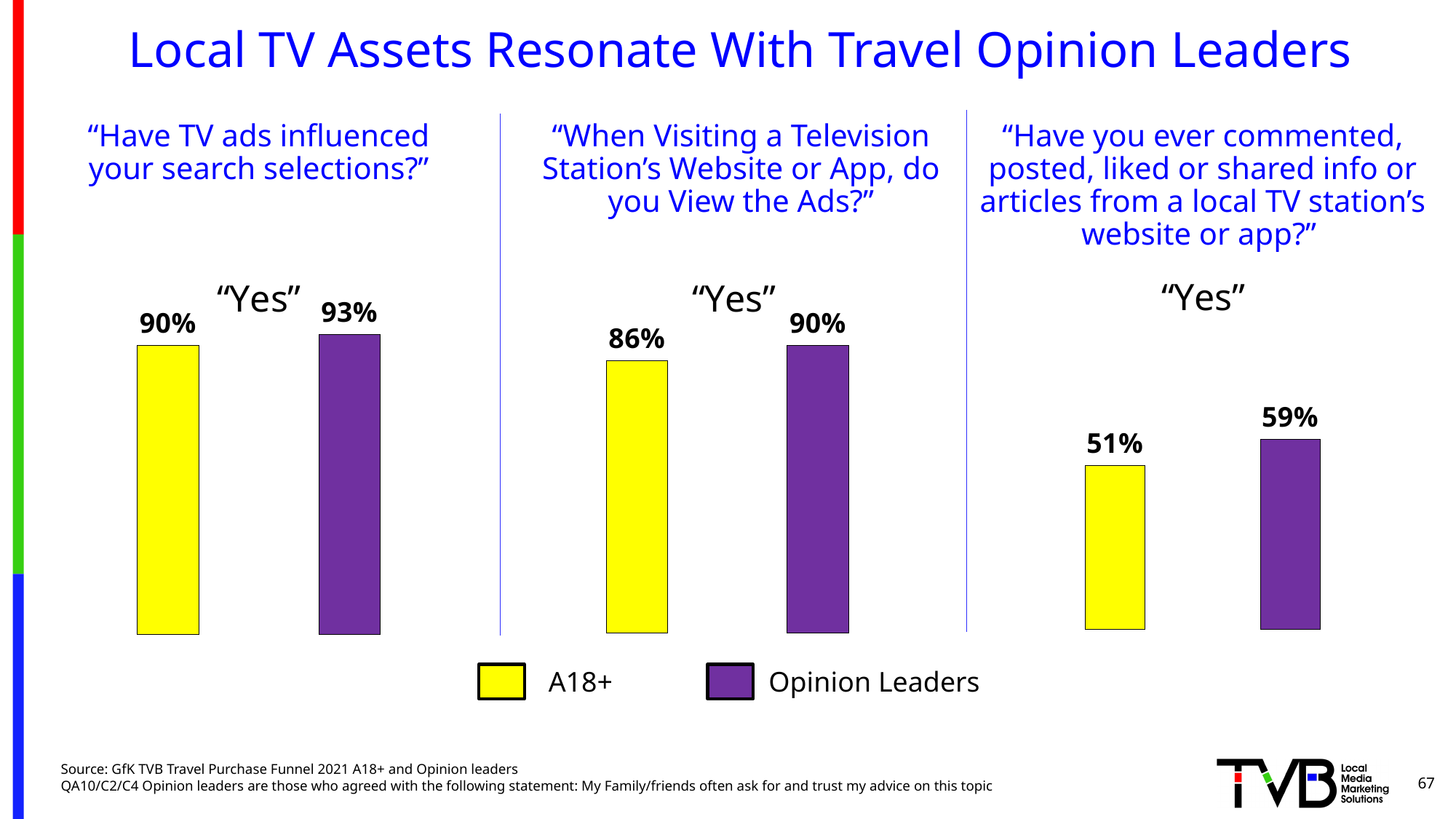
In the middle chart ("When Visiting a Television Station's Website or App, do you View the Ads?"), what is the value for A18+? 86% In the left chart ("Have TV ads influenced your search selections?"), what percentage of Opinion Leaders answered "Yes"? 93% What type of chart is used on this slide? Bar chart In the middle chart ("When Visiting a Television Station's Website or App, do you View the Ads?"), which group has the higher value, A18+ or Opinion Leaders? Opinion Leaders In the left chart ("Have TV ads influenced your search selections?"), what percentage of A18+ answered "Yes"? 90% In the right chart ("Have you ever commented, posted, liked or shared..."), what is the difference in percentage points between Opinion Leaders and A18+? 8 percentage points In the right chart ("Have you ever commented, posted, liked or shared info or articles from a local TV station's website or app?"), what is the value for A18+? 51% Which colour represents Opinion Leaders in the legend? Purple How many series does the legend list? 2 In the left chart ("Have TV ads influenced your search selections?"), what is the difference in percentage points between Opinion Leaders and A18+? 3 percentage points In the middle chart ("When Visiting a Television Station's Website or App, do you View the Ads?"), what is the value for Opinion Leaders? 90% In the right chart ("Have you ever commented, posted, liked or shared info or articles from a local TV station's website or app?"), what is the value for Opinion Leaders? 59%